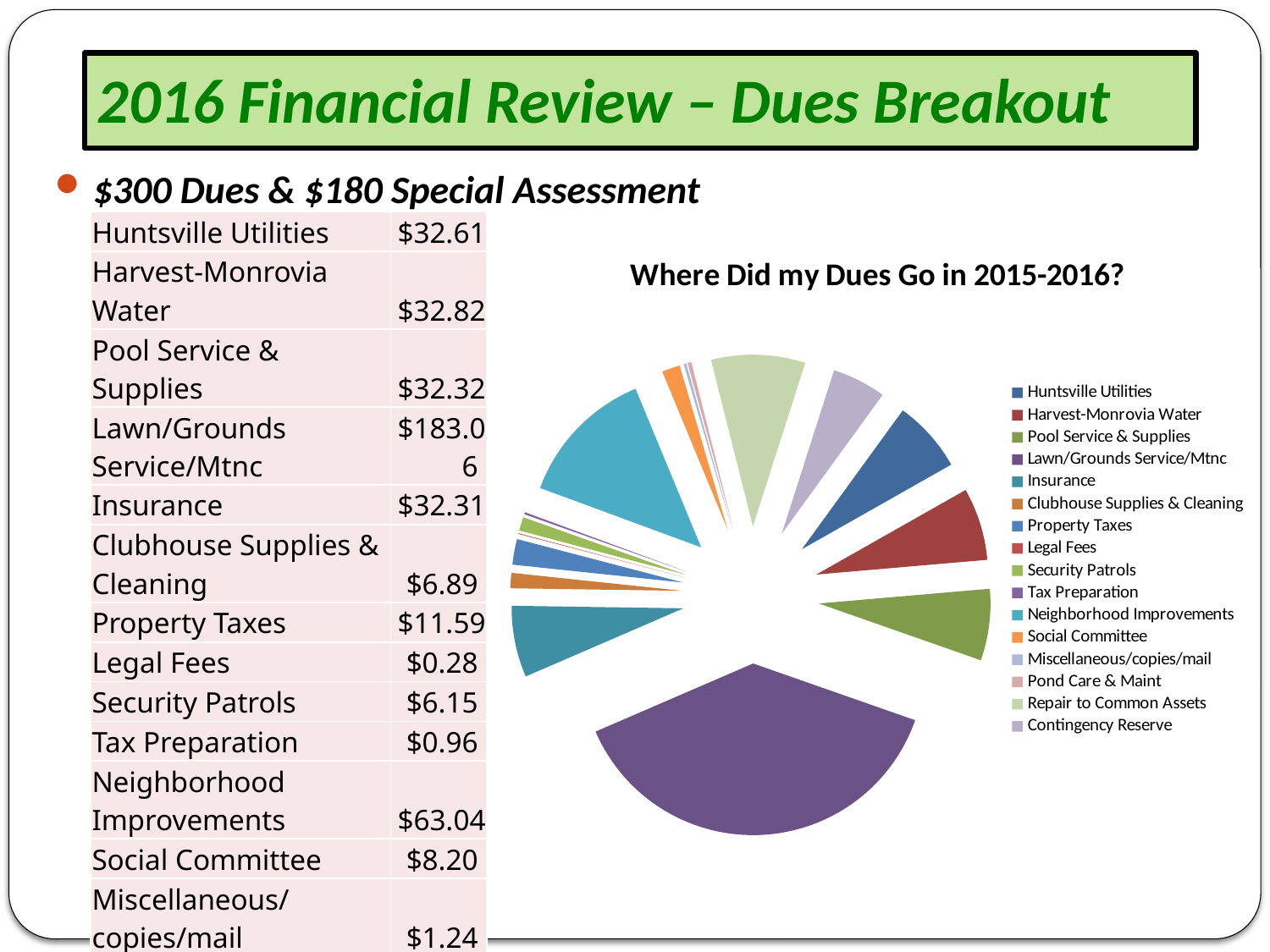
Which is larger in the pie chart, Harvest-Monrovia Water or Clubhouse Supplies & Cleaning? Harvest-Monrovia Water What is the title of the pie chart? Where Did my Dues Go in 2015-2016? What is the difference between the values for Lawn/Grounds Service/Mtnc and Neighborhood Improvements? $120.02 Which category has the largest slice in the pie chart? Lawn/Grounds Service/Mtnc What is the value shown for Legal Fees? $0.28 What is the value shown for Huntsville Utilities? $32.61 What is the value shown for Neighborhood Improvements? $63.04 What colour is the Lawn/Grounds Service/Mtnc slice in the pie chart? Purple What kind of chart is shown on the slide? Pie chart How many categories does the legend of the pie chart list? 16 What is the value shown for Property Taxes? $11.59 Which is larger in the pie chart, Lawn/Grounds Service/Mtnc or Neighborhood Improvements? Lawn/Grounds Service/Mtnc